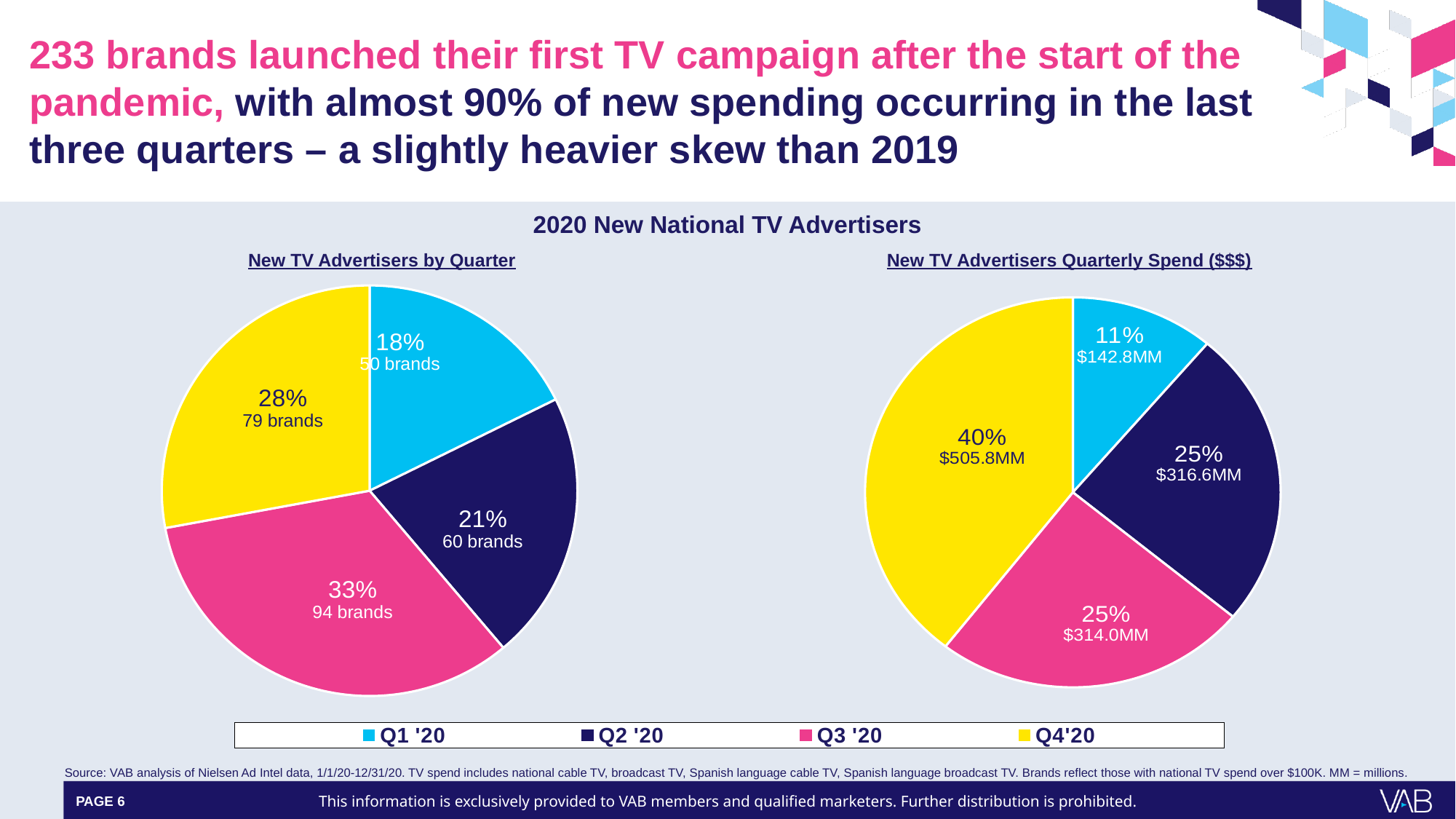
In the 'New TV Advertisers by Quarter' pie chart, how many more brands are shown for Q3 '20 than for Q2 '20? 34 brands How many series does the shared legend list? 4 In the 'New TV Advertisers Quarterly Spend ($$$)' pie chart, what share of spend does Q1 '20 account for? 11% In the 'New TV Advertisers by Quarter' pie chart, which quarter has the largest slice? Q3 '20 What type of chart is used for 'New TV Advertisers by Quarter'? Pie chart In the 'New TV Advertisers Quarterly Spend ($$$)' pie chart, what is the difference between Q4'20 spend and Q1 '20 spend? $363.0MM In the 'New TV Advertisers Quarterly Spend ($$$)' pie chart, what is the spend for Q4'20? $505.8MM In the 'New TV Advertisers by Quarter' pie chart, how many brands are shown for Q4'20? 79 brands In the 'New TV Advertisers Quarterly Spend ($$$)' pie chart, which quarter has the largest share of spend? Q4'20 In the 'New TV Advertisers by Quarter' pie chart, what share of new advertisers came in Q3 '20? 33% In the 'New TV Advertisers Quarterly Spend ($$$)' pie chart, which is larger, the spend for Q2 '20 or Q3 '20? Q2 '20 In the 'New TV Advertisers by Quarter' pie chart, which quarter has the smallest slice? Q1 '20